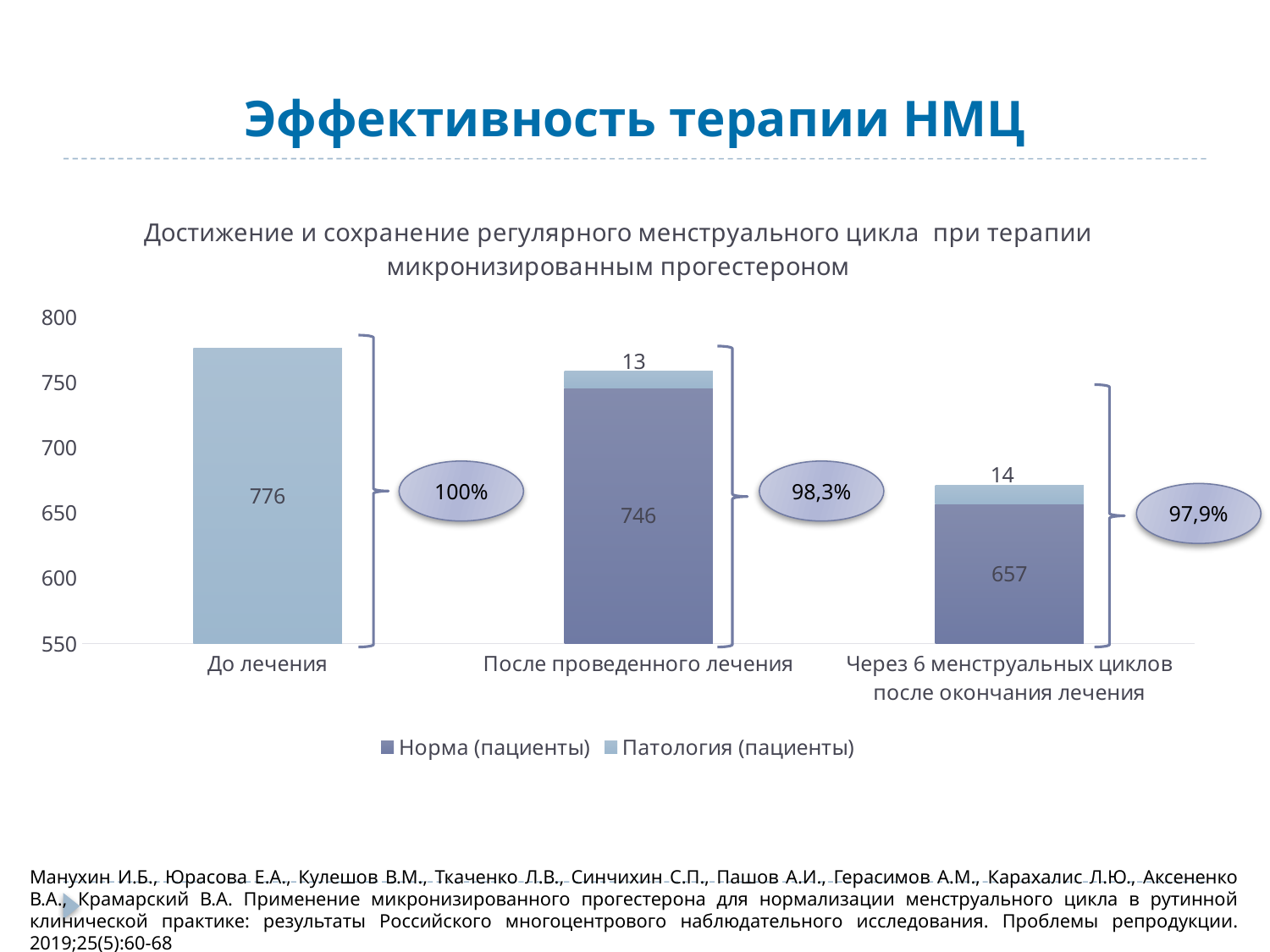
What is the value of Патология (пациенты) for После проведенного лечения? 13 What type of chart is shown on the slide? stacked bar chart What is the difference between the Норма (пациенты) values for После проведенного лечения and Через 6 менструальных циклов после окончания лечения? 89 What is the value of Норма (пациенты) for Через 6 менструальных циклов после окончания лечения? 657 How many series does the chart legend list? 2 What is the value of Норма (пациенты) for После проведенного лечения? 746 How many categories are shown on the x axis of the chart? 3 What percentage is shown in the oval next to the bar for После проведенного лечения? 98,3% What is the value of Патология (пациенты) for Через 6 менструальных циклов после окончания лечения? 14 Which category has the lowest Норма (пациенты) value among those where it is labelled? Через 6 менструальных циклов после окончания лечения What is the total of the stacked bar for После проведенного лечения? 759 What value is labelled on the bar for До лечения? 776